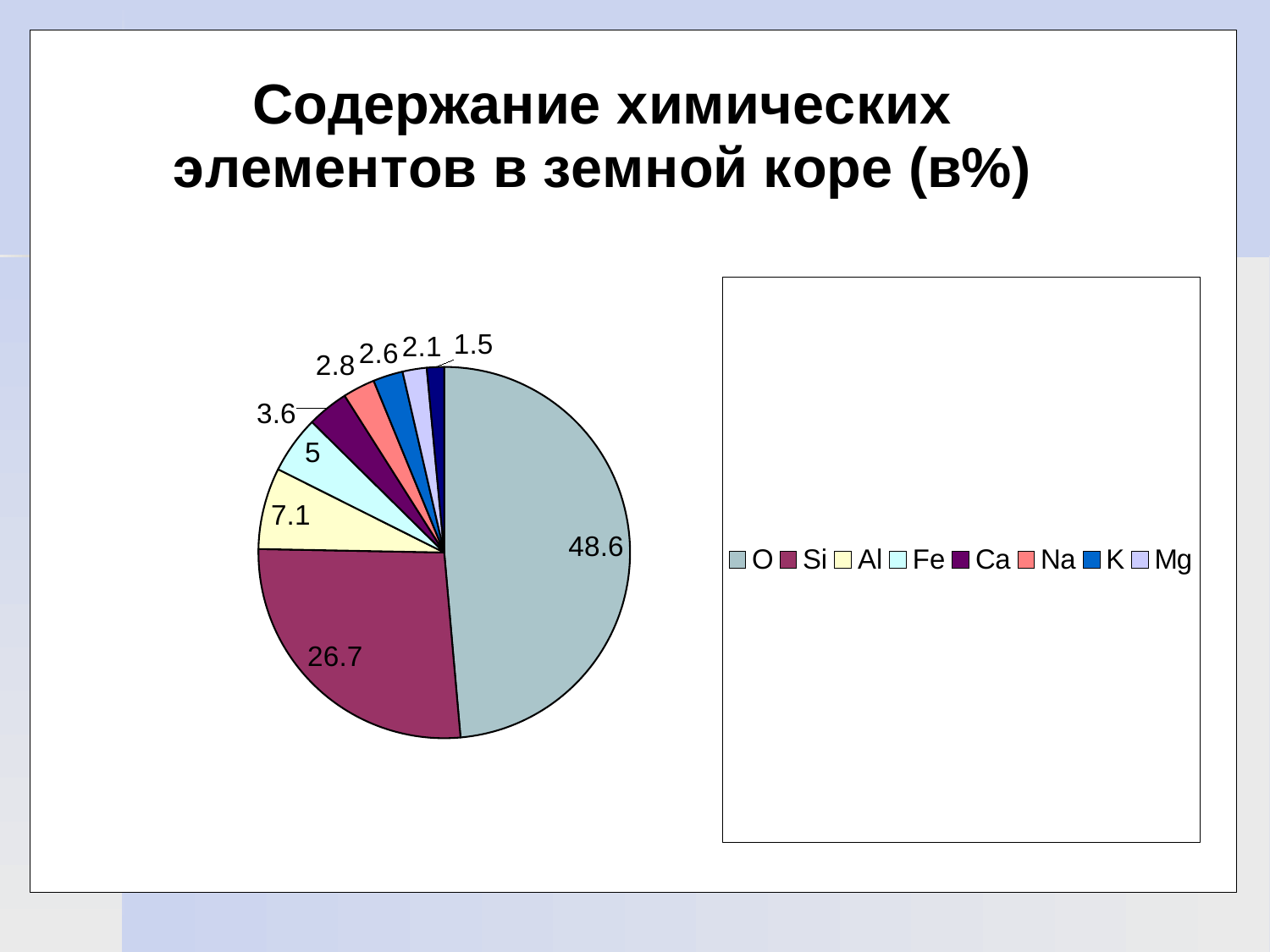
How many entries does the legend list? 8 How many slices does the pie chart have? 9 What is the value for Mg in the pie chart? 2.1 What is the difference between the values for O and Si? 21.9 What is the value for O (oxygen) in the pie chart? 48.6 Which is larger, the value for Al or the value for Fe? Al What is the value for Fe in the pie chart? 5 Which element has the largest slice in the pie chart? O What is the value for Si in the pie chart? 26.7 What is the value for Ca in the pie chart? 3.6 What is the smallest value labelled on the pie chart? 1.5 What is the value for Al in the pie chart? 7.1